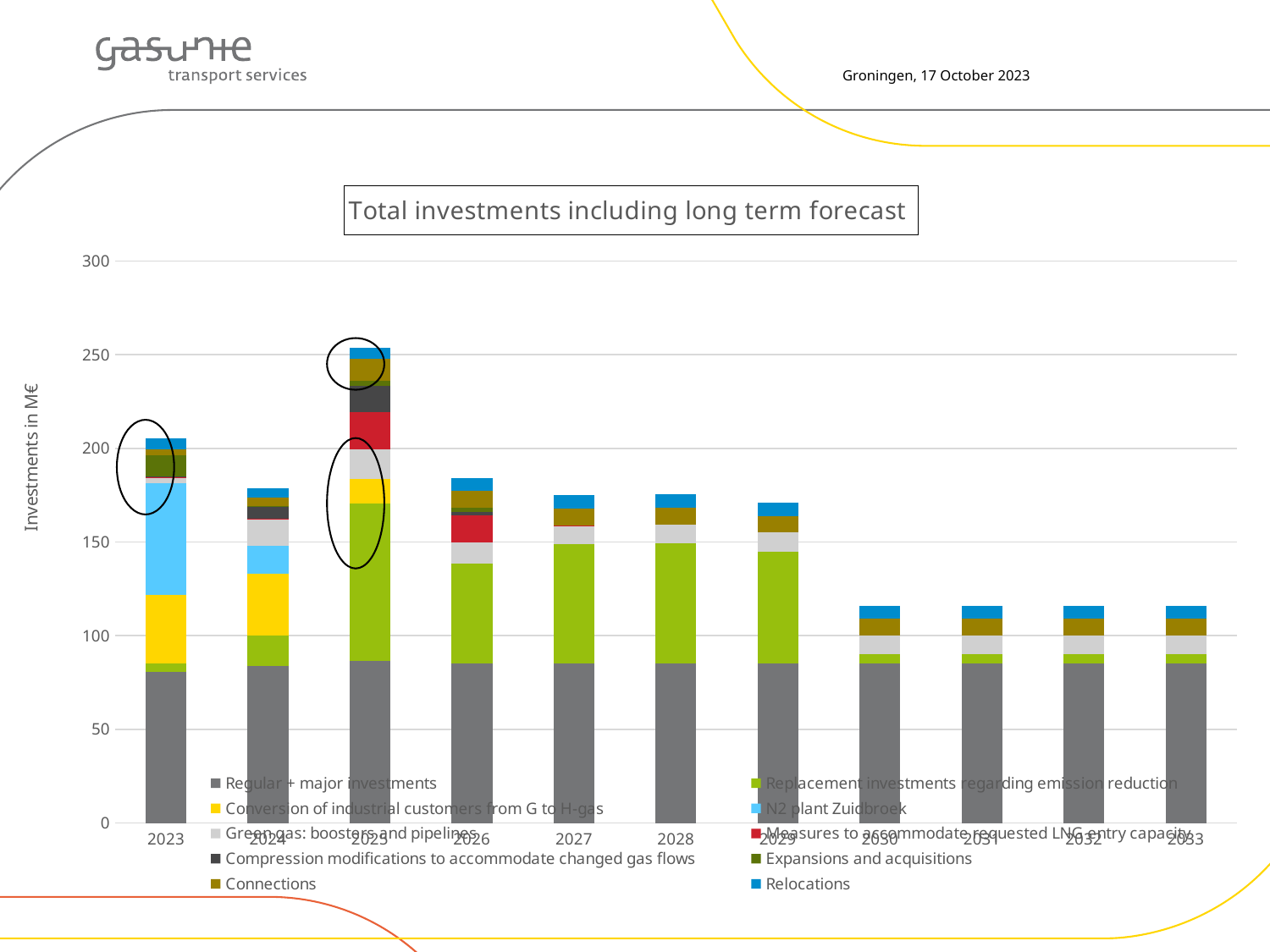
Is the total investment for 2030 greater or less than 100? greater What is the label on the y axis of the chart? Investments in M€ Is the total investment for 2031 greater or less than 150? less Do the total investments rise or fall from 2025 to 2030? fall How many years are shown on the x axis of the chart? 11 Which year has the highest total investment in the chart? 2025 Is the total investment for 2024 greater or less than 200? less What kind of chart is shown on the slide? Stacked bar chart What is the title of the chart? Total investments including long term forecast Which year has the larger total investment, 2023 or 2024? 2023 How many series does the chart's legend list? 10